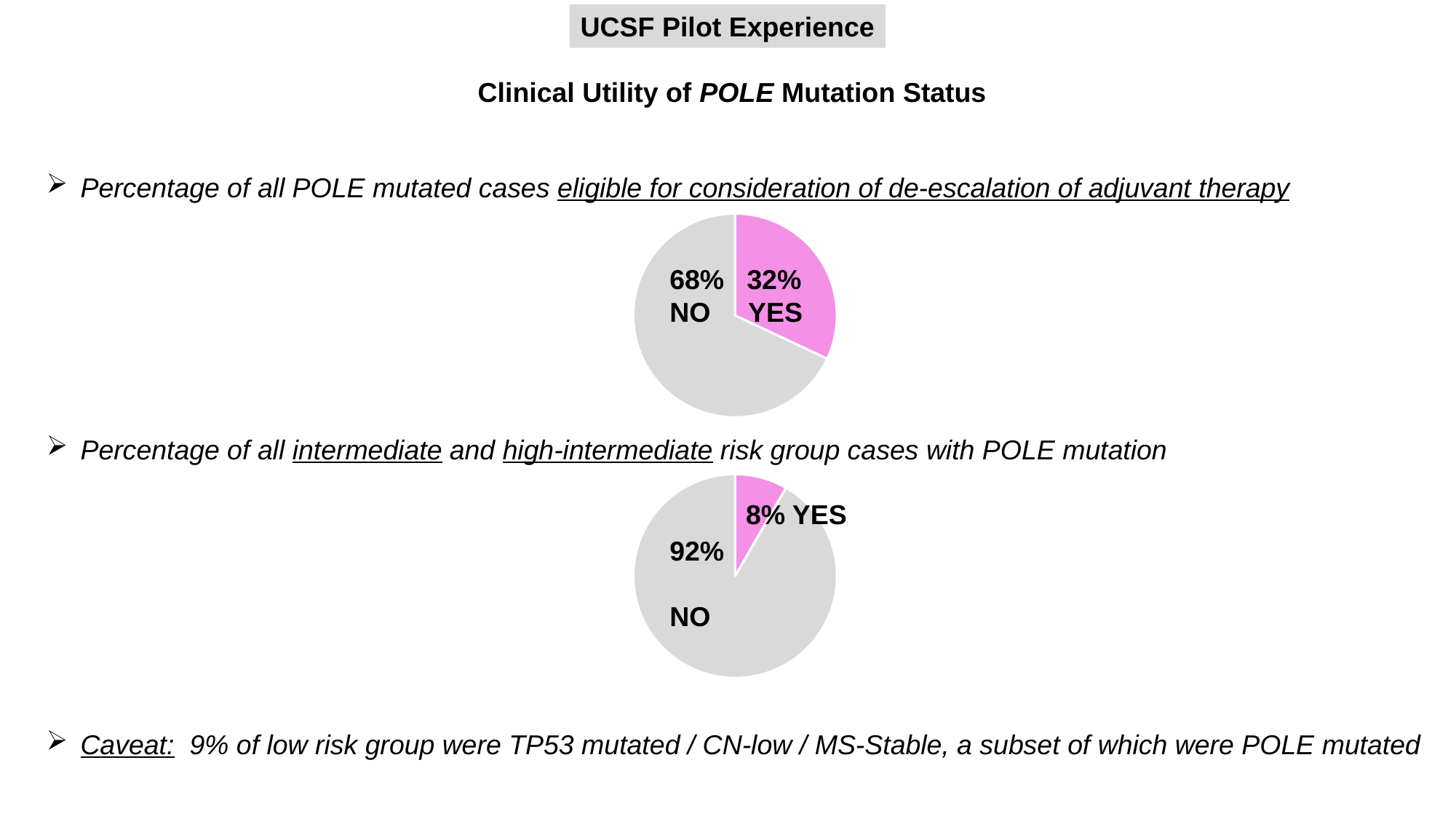
In the bottom pie chart (intermediate and high-intermediate risk group cases with POLE mutation), what percentage is labelled YES? 8% What type of chart is used for the top chart on the slide? Pie chart How many pie charts are shown on the slide? 2 In the top pie chart, which slice is larger, YES or NO? NO In the top pie chart, what colour is the YES slice? Pink In the bottom pie chart (intermediate and high-intermediate risk group cases with POLE mutation), what percentage is labelled NO? 92% How many slices does the bottom pie chart have? 2 In the top pie chart (eligible for consideration of de-escalation of adjuvant therapy), what percentage is labelled YES? 32% In the top pie chart (eligible for consideration of de-escalation of adjuvant therapy), what percentage is labelled NO? 68% In the top pie chart, what is the difference between the NO and YES percentages? 36% In the bottom pie chart, what is the difference between the NO and YES percentages? 84% In the bottom pie chart, which slice is the smallest? YES